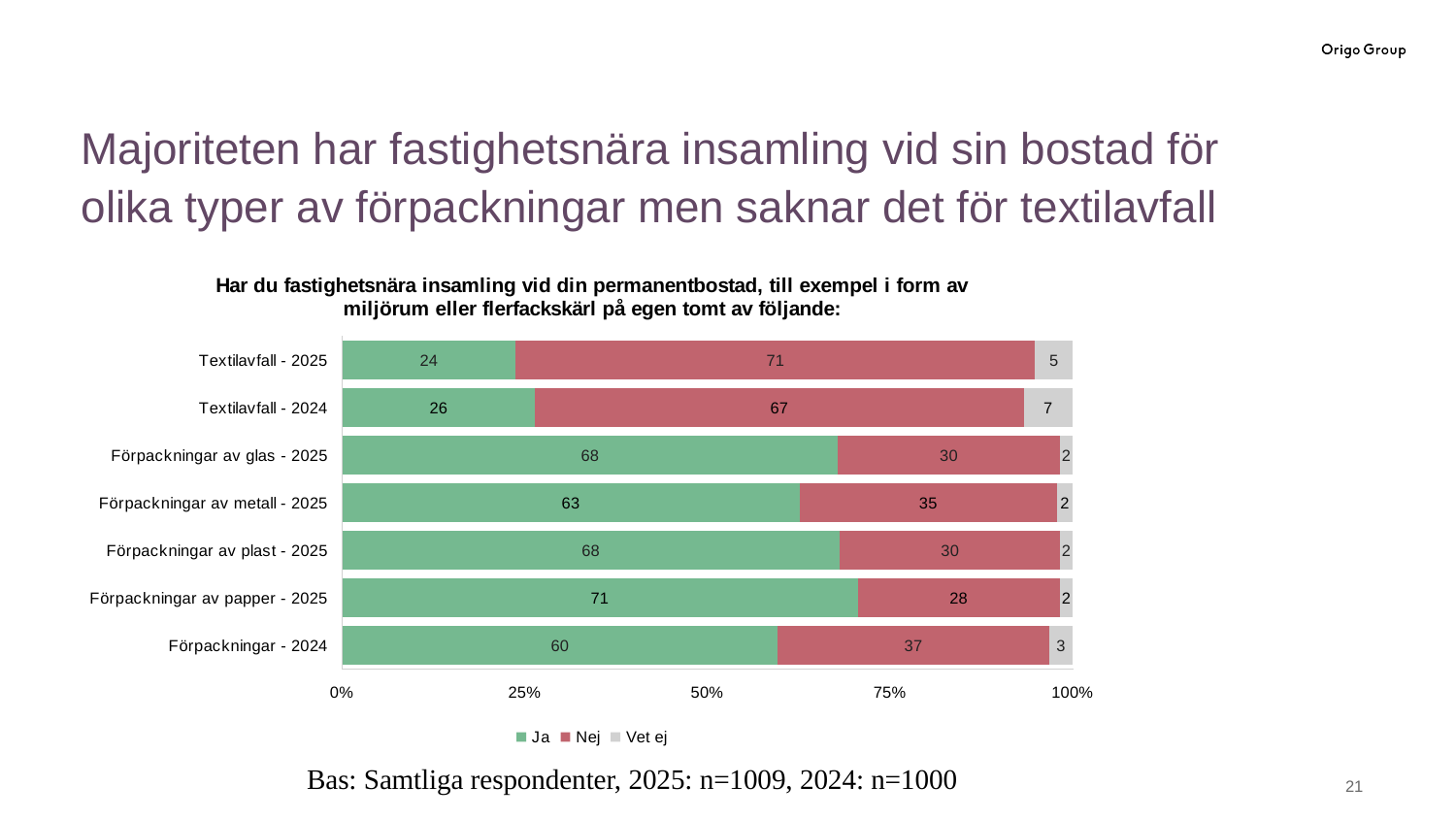
Which series is shown in green in the legend? Ja What is the difference between the "Nej" values for Textilavfall - 2025 and Textilavfall - 2024? 4 What is the "Ja" value for Textilavfall - 2025? 24 Which category has the highest "Ja" value? Förpackningar av papper - 2025 What kind of chart is shown on the slide? Stacked bar chart Which is larger, the "Ja" value for Förpackningar - 2024 or the "Ja" value for Förpackningar av metall - 2025? Förpackningar av metall - 2025 What is the total of the stacked bar for Förpackningar av glas - 2025? 100 Which category has the lowest "Ja" value? Textilavfall - 2025 What is the "Vet ej" value for Textilavfall - 2024? 7 What is the "Nej" value for Förpackningar av metall - 2025? 35 How many series does the legend list? 3 How many categories are shown on the chart? 7